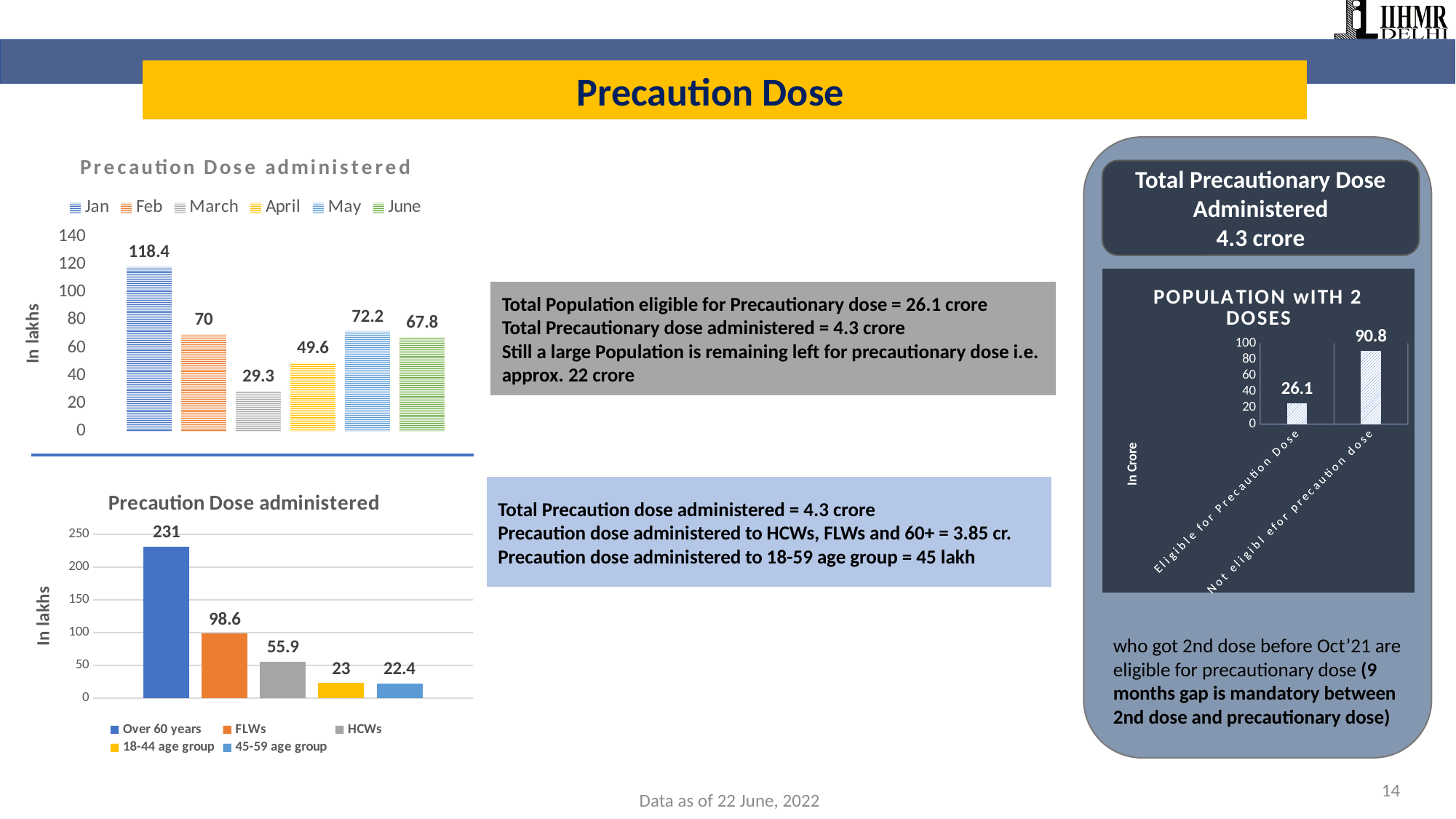
In the bottom-left 'Precaution Dose administered' chart (by group), how many bars are plotted? 5 In the bottom-left 'Precaution Dose administered' chart (by group), what is the difference between the HCWs value and the 18-44 age group value? 32.9 In the 'POPULATION wITH 2 DOSES' chart, what unit is shown on the vertical axis label? In Crore In the top-left monthly 'Precaution Dose administered' chart, which is larger, the value for May or the value for June? May What kind of chart is the 'POPULATION wITH 2 DOSES' chart? Bar chart In the top-left chart titled 'Precaution Dose administered' (by month), what is the value for Jan? 118.4 In the bottom-left 'Precaution Dose administered' chart (by group), what is the value for FLWs? 98.6 In the top-left monthly 'Precaution Dose administered' chart, which month has the lowest value? March In the top-left monthly 'Precaution Dose administered' chart, how many series does the legend list? 6 In the top-left monthly 'Precaution Dose administered' chart, what is the difference between the Jan and Feb values? 48.4 In the bottom-left 'Precaution Dose administered' chart (by group), which group has the highest value? Over 60 years In the 'POPULATION wITH 2 DOSES' chart, what is the value for 'Not eligible for precaution dose'? 90.8